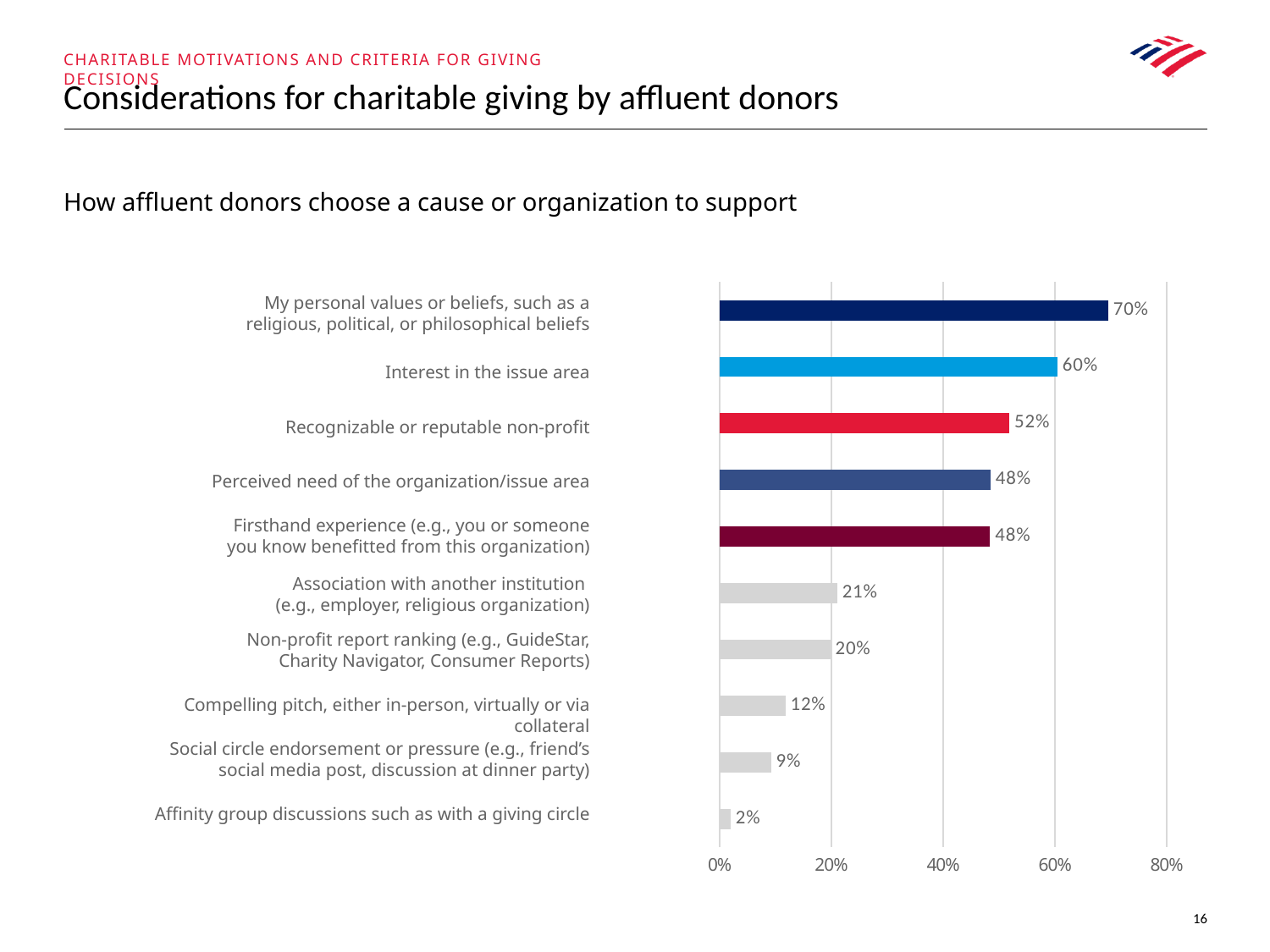
Which consideration has the lowest percentage? Affinity group discussions such as with a giving circle What is the highest value shown on the x axis of the chart? 80% What kind of chart is shown on the slide? Bar chart Which is larger: the value for "Compelling pitch, either in-person, virtually or via collateral" or "Social circle endorsement or pressure"? Compelling pitch, either in-person, virtually or via collateral What percentage is shown for "Affinity group discussions such as with a giving circle"? 2% Which consideration has the highest percentage? My personal values or beliefs, such as a religious, political, or philosophical beliefs What is the difference between the values for "My personal values or beliefs" and "Interest in the issue area"? 10% What is the difference between the values for "Association with another institution" and "Non-profit report ranking"? 1% How many considerations (bars) are shown in the chart? 10 What percentage of affluent donors cite "Interest in the issue area" as a consideration? 60% What is the value for "Recognizable or reputable non-profit"? 52% What is the value for "Non-profit report ranking (e.g., GuideStar, Charity Navigator, Consumer Reports)"? 20%